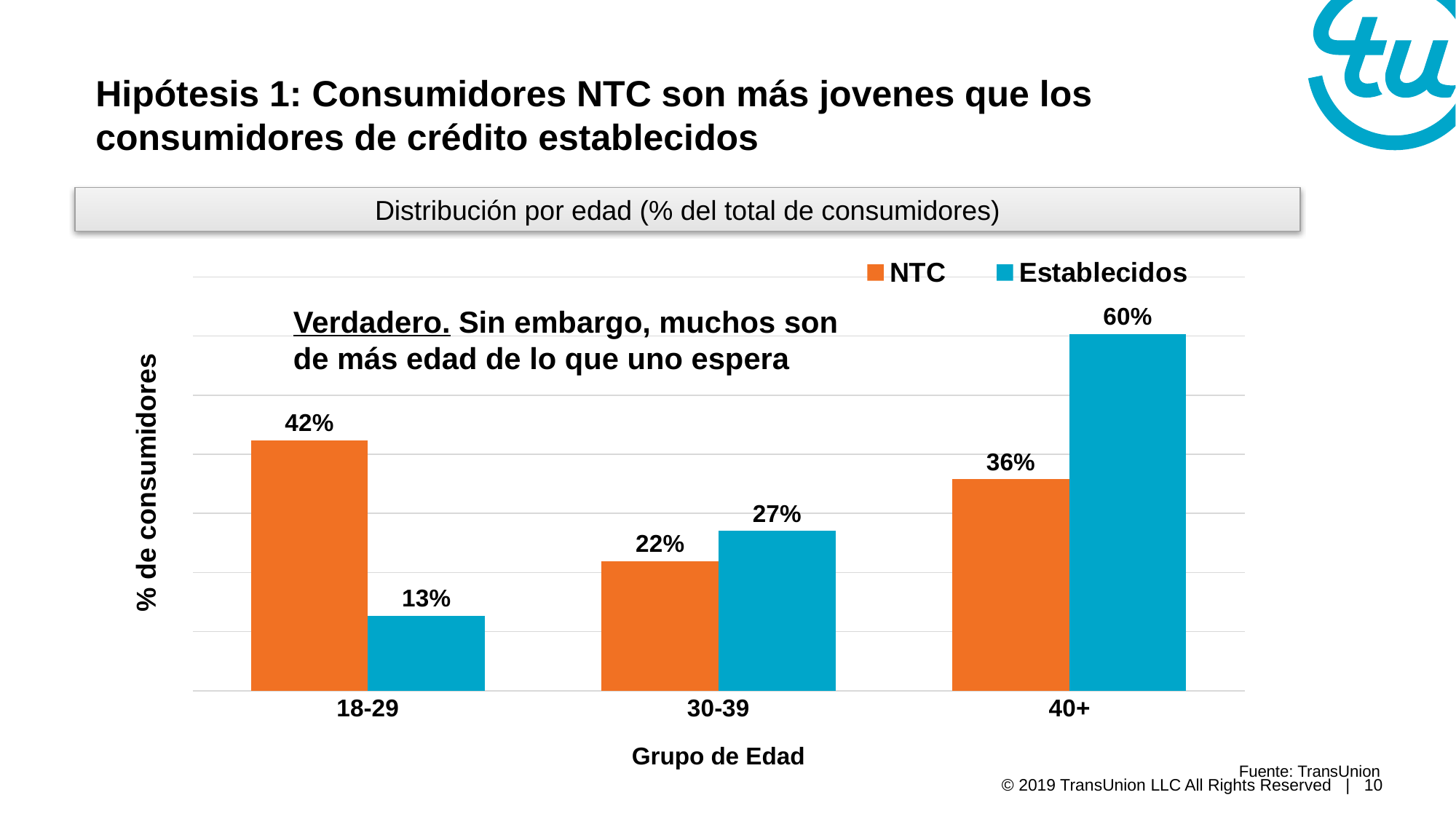
What is the difference between the NTC and Establecidos values for the 18-29 age group? 29% How many series does the legend list? 2 What is the Establecidos value for the 40+ age group? 60% What is the label of the x axis? Grupo de Edad How many age groups are shown on the x axis? 3 Which age group has the lowest Establecidos value? 18-29 For the 30-39 age group, which series has the larger value, NTC or Establecidos? Establecidos What kind of chart is shown on the slide? Bar chart What is the Establecidos value for the 30-39 age group? 27% What is the NTC value for the 18-29 age group? 42% What is the difference between the Establecidos and NTC values for the 40+ age group? 24% Which age group has the highest NTC value? 18-29